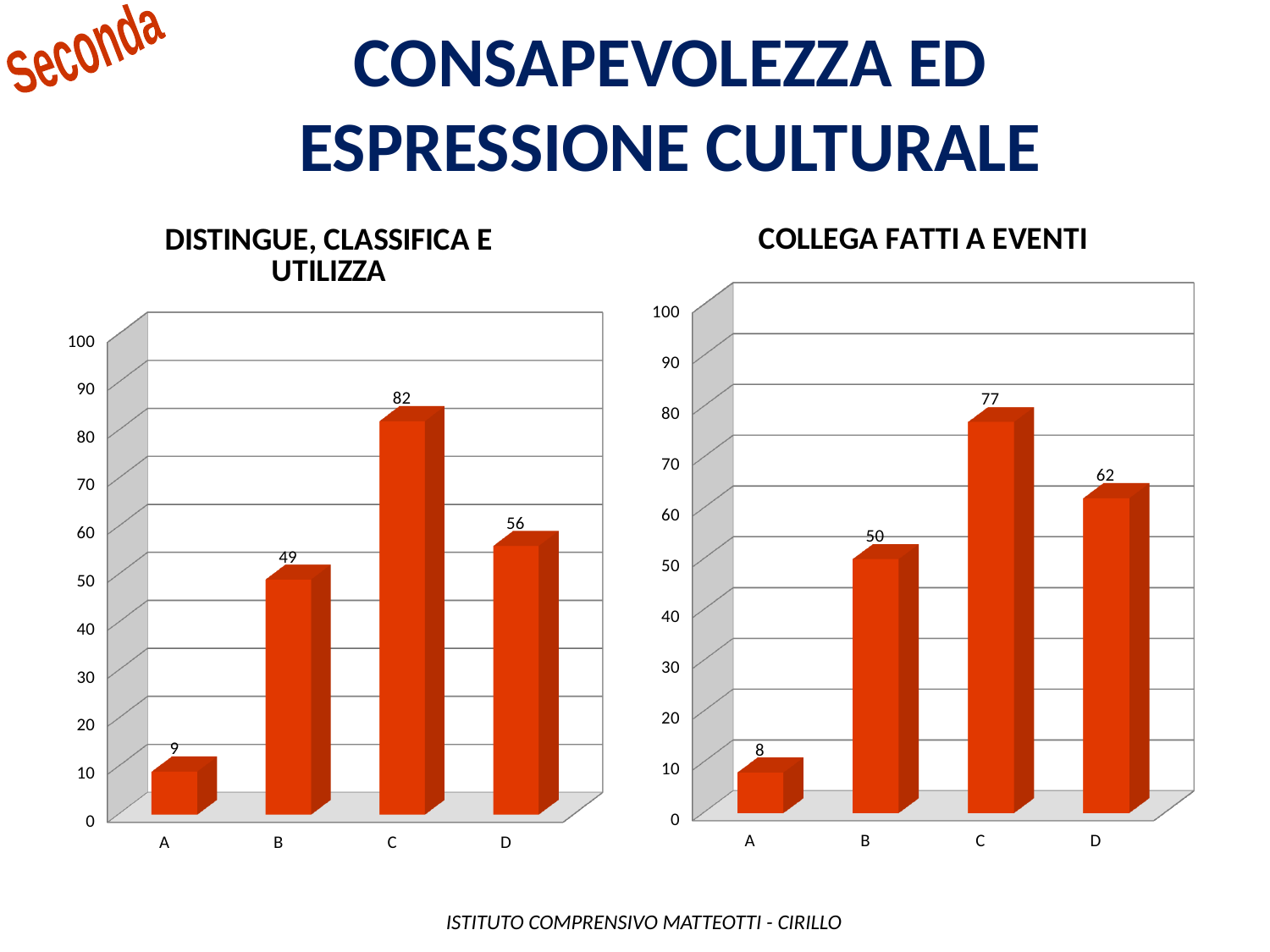
In the 'COLLEGA FATTI A EVENTI' chart, is the value for C greater or less than 70? greater What kind of chart is the 'DISTINGUE, CLASSIFICA E UTILIZZA' chart? Bar chart In the 'DISTINGUE, CLASSIFICA E UTILIZZA' chart, which is larger, the value for B or the value for D? D In the 'DISTINGUE, CLASSIFICA E UTILIZZA' chart, what is the difference between the values for C and D? 26 In the 'DISTINGUE, CLASSIFICA E UTILIZZA' chart, what is the value for category C? 82 In the 'DISTINGUE, CLASSIFICA E UTILIZZA' chart, what is the value for category A? 9 In the 'COLLEGA FATTI A EVENTI' chart, what is the value for category B? 50 In the 'COLLEGA FATTI A EVENTI' chart, which category has the highest value? C What is the title of the chart on the right side of the slide? COLLEGA FATTI A EVENTI In the 'COLLEGA FATTI A EVENTI' chart, what is the difference between the values for D and A? 54 How many categories are shown in the 'COLLEGA FATTI A EVENTI' chart? 4 In the 'DISTINGUE, CLASSIFICA E UTILIZZA' chart, which category has the lowest value? A